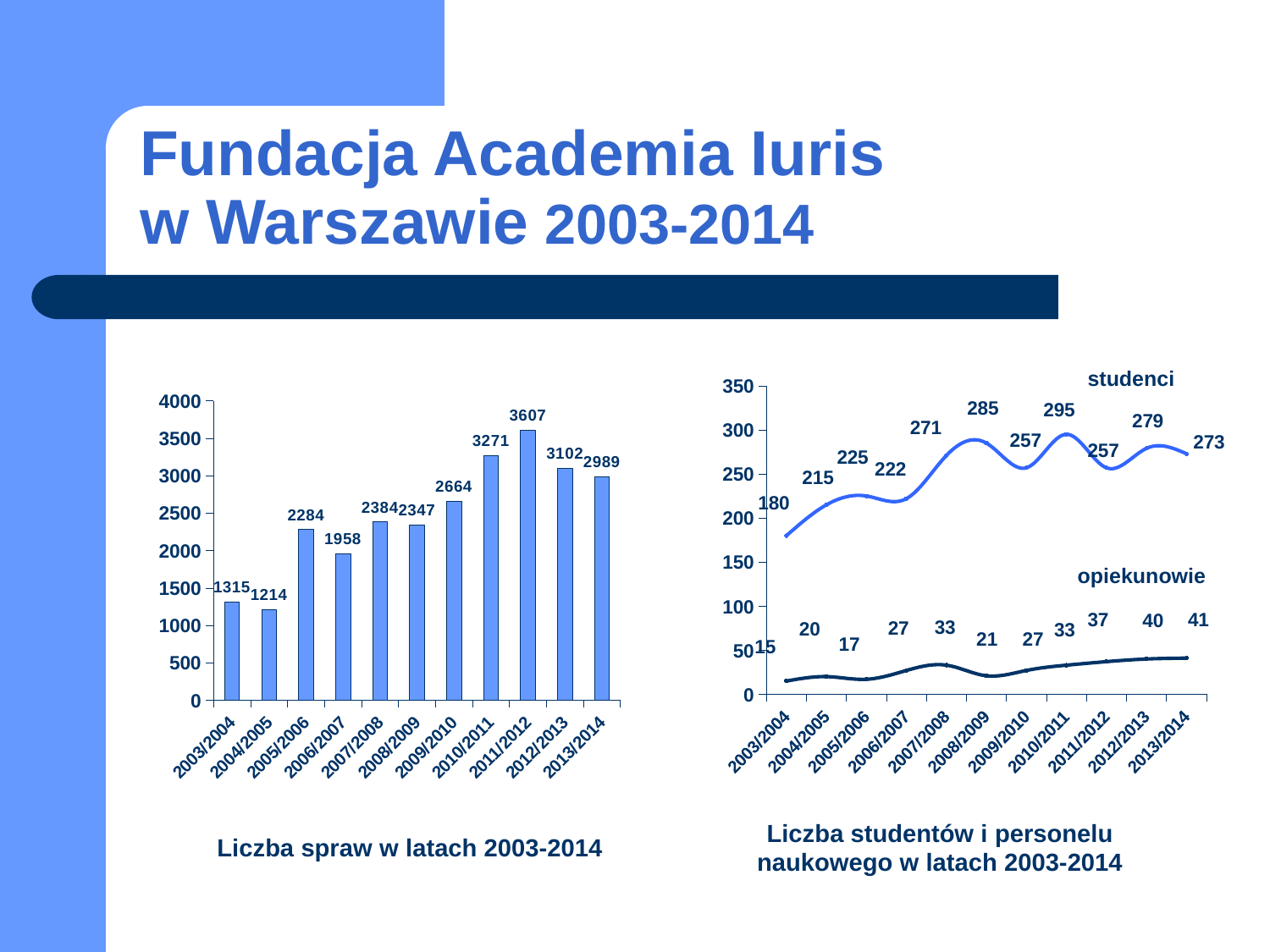
In the chart 'Liczba spraw w latach 2003-2014', how many years are shown on the x axis? 11 What kind of chart is 'Liczba studentów i personelu naukowego w latach 2003-2014'? line chart In the chart 'Liczba studentów i personelu naukowego w latach 2003-2014', what is the value for opiekunowie in 2013/2014? 41 In the chart 'Liczba studentów i personelu naukowego w latach 2003-2014', what is the value for studenci in 2010/2011? 295 In the chart 'Liczba spraw w latach 2003-2014', what is the difference between the values for 2011/2012 and 2012/2013? 505 In the chart 'Liczba spraw w latach 2003-2014', which is larger, the value for 2007/2008 or 2008/2009? 2007/2008 What kind of chart is 'Liczba spraw w latach 2003-2014'? bar chart In the chart 'Liczba spraw w latach 2003-2014', which year has the lowest value? 2004/2005 In the chart 'Liczba studentów i personelu naukowego w latach 2003-2014', what is the difference between studenci and opiekunowie in 2013/2014? 232 How many series are plotted in the chart 'Liczba studentów i personelu naukowego w latach 2003-2014'? 2 In the chart 'Liczba spraw w latach 2003-2014', what is the value for 2011/2012? 3607 In the chart 'Liczba studentów i personelu naukowego w latach 2003-2014', in which year is the studenci value lowest? 2003/2004